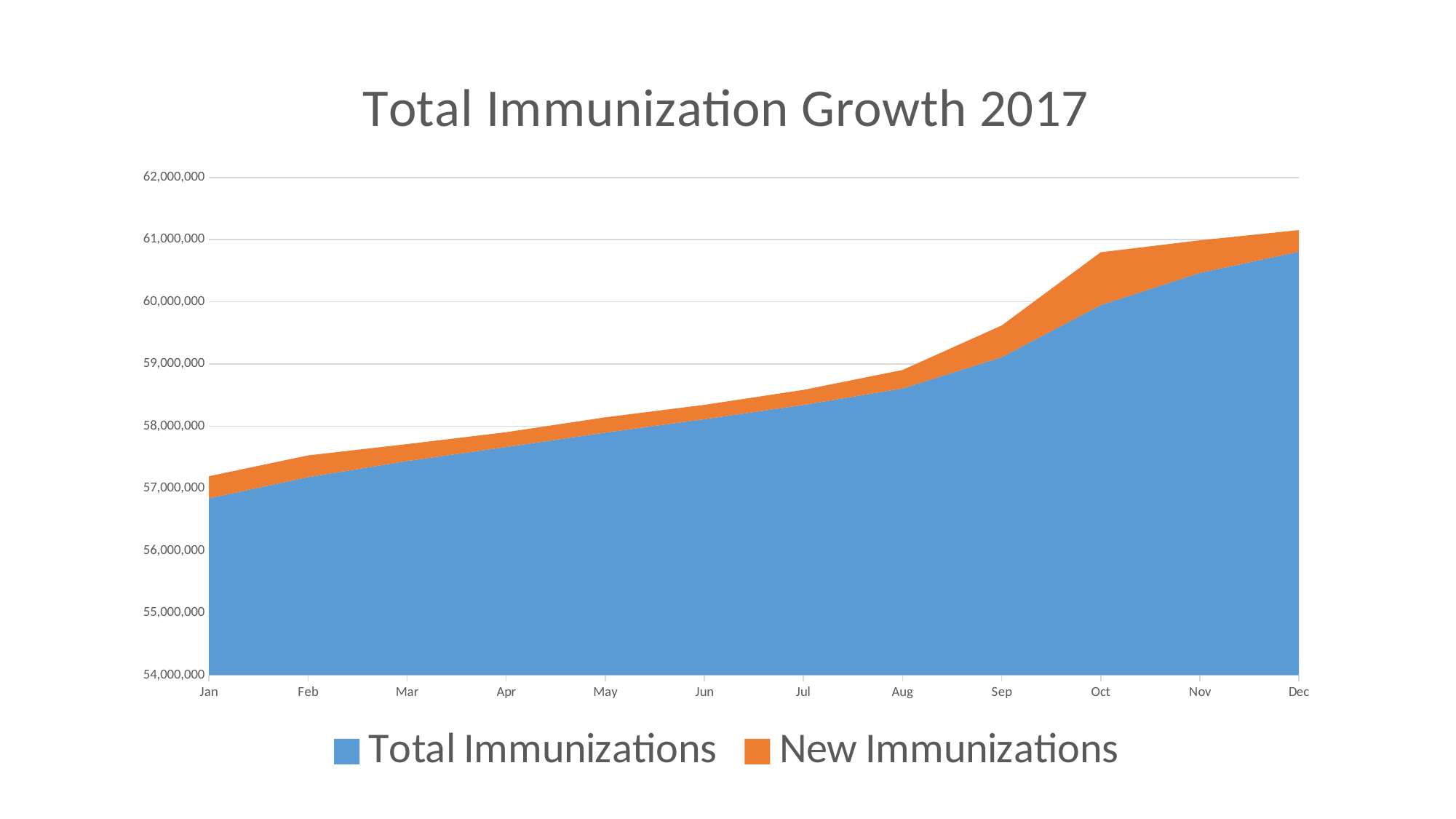
What kind of chart is shown on the slide? Stacked area chart In which month is the Total Immunizations value lowest? Jan Which series is shown in orange? New Immunizations Is the Total Immunizations value for Dec greater or less than 60,000,000? greater What is the title of the chart? Total Immunization Growth 2017 Is the Total Immunizations value for Jul greater or less than 58,000,000? greater How many months are plotted along the x axis? 12 Which month has the larger Total Immunizations value, Feb or Nov? Nov How many series does the legend list? 2 Do the Total Immunizations values rise or fall from Jan to Dec? Rise In which month is the Total Immunizations value highest? Dec Is the Total Immunizations value for Mar greater or less than 58,000,000? less